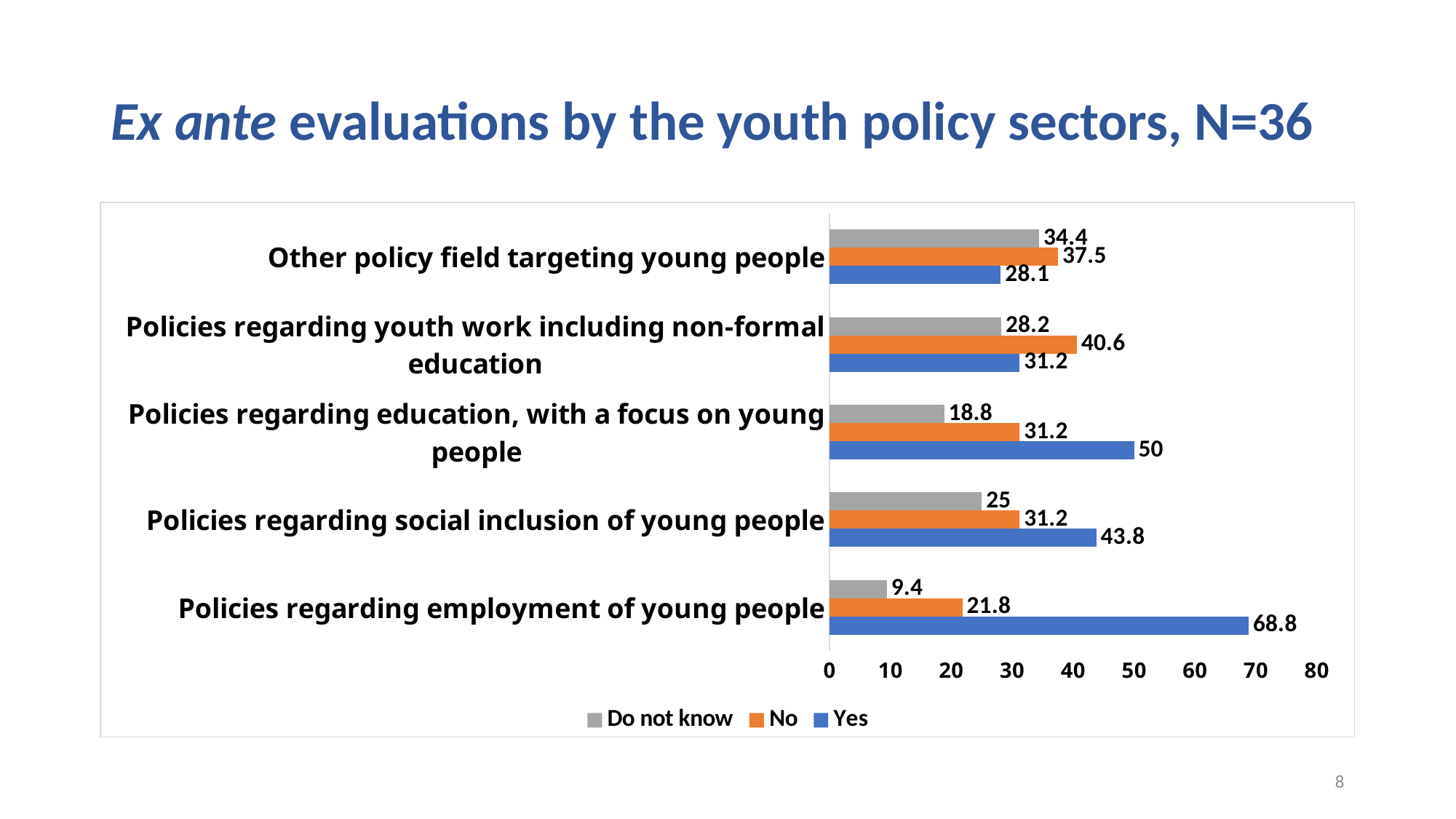
Which is larger for Other policy field targeting young people: the 'No' value or the 'Yes' value? No What is the 'Do not know' value for Policies regarding education, with a focus on young people? 18.8 Which policy sector has the highest 'Yes' value? Policies regarding employment of young people What is the 'Yes' value for Policies regarding employment of young people? 68.8 How many policy sectors are shown on the chart? 5 What is the 'No' value for Policies regarding youth work including non-formal education? 40.6 What is the difference between the 'Yes' values for Policies regarding employment of young people and Policies regarding social inclusion of young people? 25 What kind of chart is shown on the slide? Bar chart How many series does the legend list? 3 Which policy sector has the lowest 'Do not know' value? Policies regarding employment of young people Which series is shown in orange in the legend? No Is the 'Yes' value for Policies regarding social inclusion of young people greater or less than 40? greater